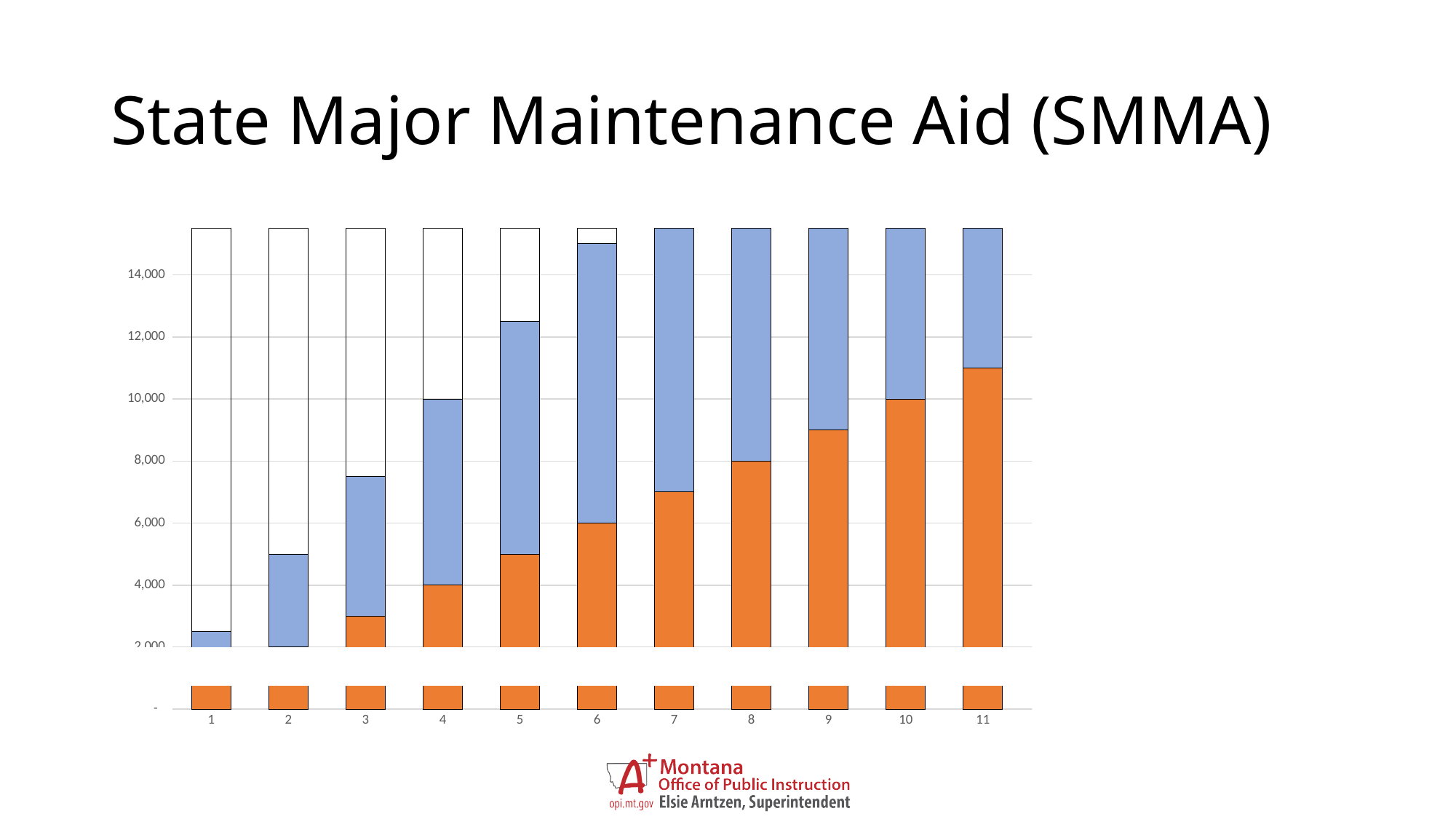
What is the value of the orange segment for category 8? 8,000 What is the value of the orange segment for category 4? 4,000 Which category has the largest orange segment? 11 Which has a larger orange segment, category 5 or category 9? Category 9 Do the orange segments rise or fall from category 1 to category 11? Rise Is the orange segment for category 3 greater or less than 4,000? less How many categories are shown along the x axis of the chart? 11 What is the value of the orange segment for category 10? 10,000 What is the title of the slide containing the chart? State Major Maintenance Aid (SMMA) Is the top of the blue segment for category 5 greater or less than 12,000? greater What kind of chart is shown on the slide? Stacked bar chart Is the orange segment for category 11 greater or less than 10,000? greater